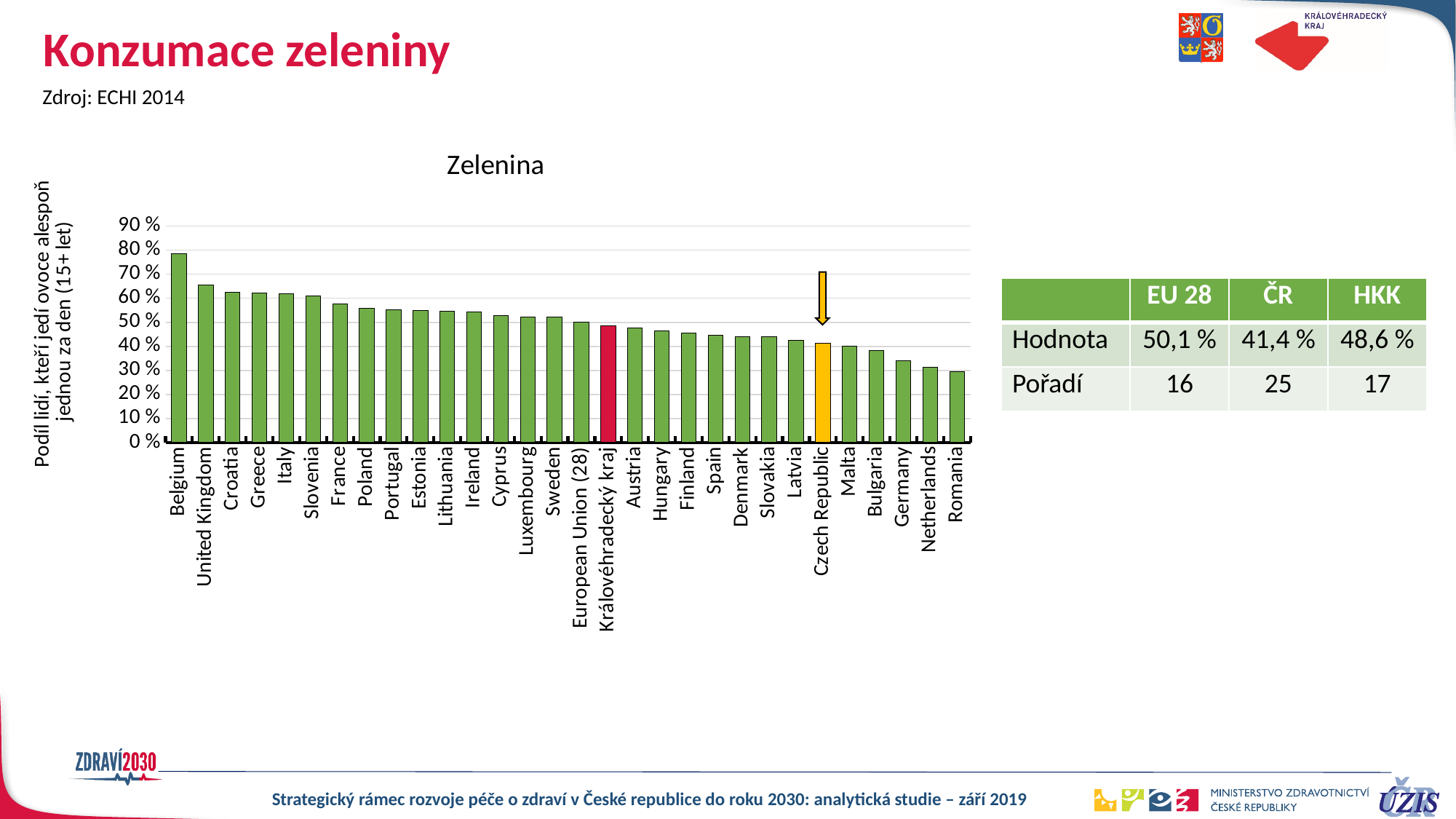
What is the title of the chart? Zelenina Which category has the lowest value in the chart? Romania Which is larger, the value for Královéhradecký kraj or the value for Czech Republic? Královéhradecký kraj What is the value for Czech Republic? 41,4 % Do the values rise or fall from left to right along the x axis? fall What is the value for European Union (28)? 50,1 % What kind of chart is shown on the slide? bar chart What is the value for Královéhradecký kraj? 48,6 % What is the difference between the values for European Union (28) and Czech Republic? 8,7 % How many countries/regions are plotted in the chart? 30 Is the value for Belgium greater or less than 70 %? greater Which category has the highest value in the chart? Belgium